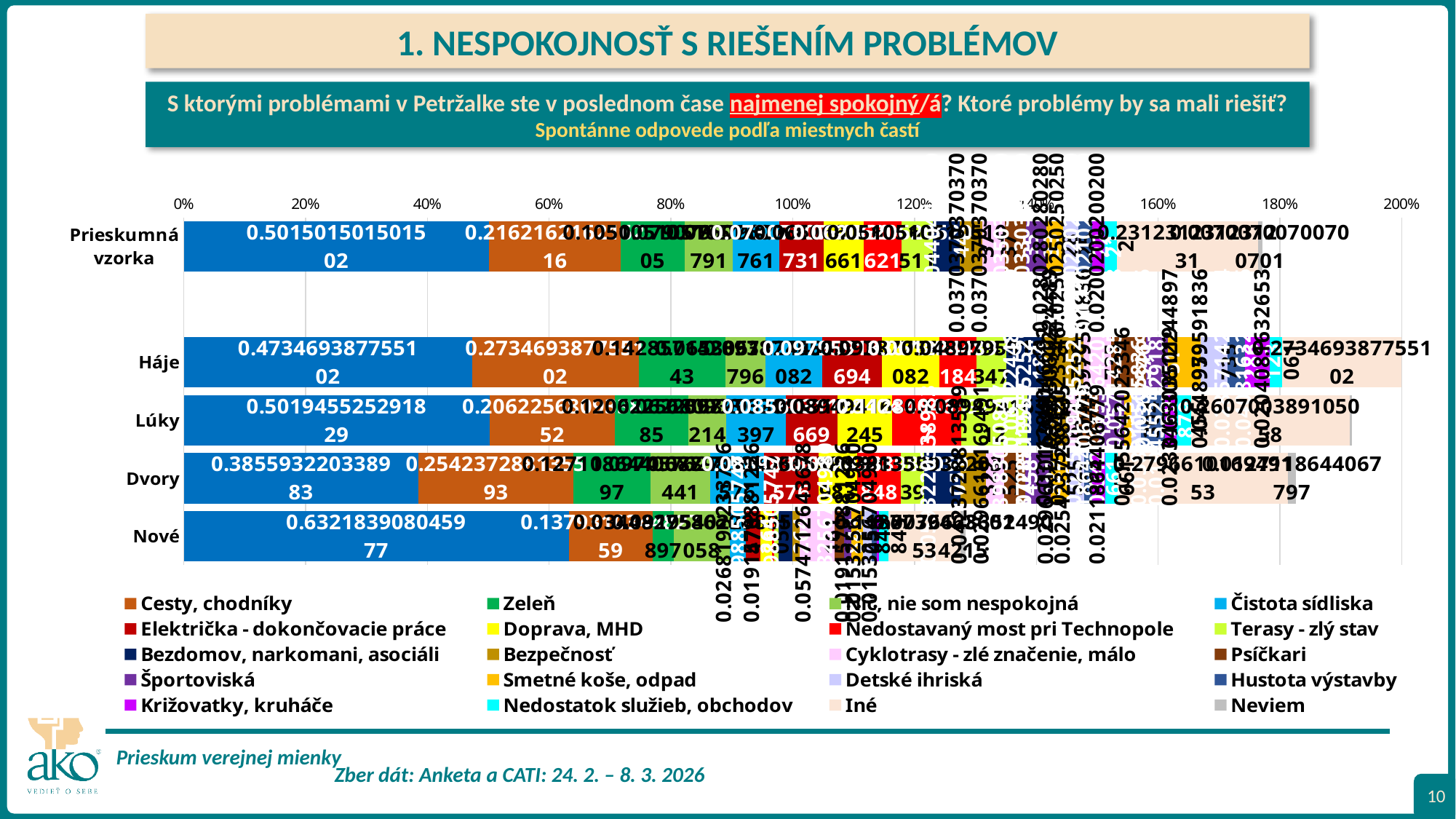
How many series does the legend list? 20 What is the value of the first (blue) segment for Háje? 0.473469387755102 What is the value of the first (blue) segment for Prieskumná vzorka? 0.501501501501502 What is the value of the first (blue) segment for Nové? 0.632183908045977 Which category has the smallest first (blue) segment? Dvory What is the value of the first (blue) segment for Dvory? 0.385593220338983 Is the first (blue) segment for Nové greater or less than 60%? greater What is the value of the Cesty, chodníky (brown) segment for Prieskumná vzorka? 0.216216216216216 What kind of chart is shown on the slide? bar chart How many categories (rows) are plotted on the chart? 5 Which category has the largest first (blue) segment? Nové